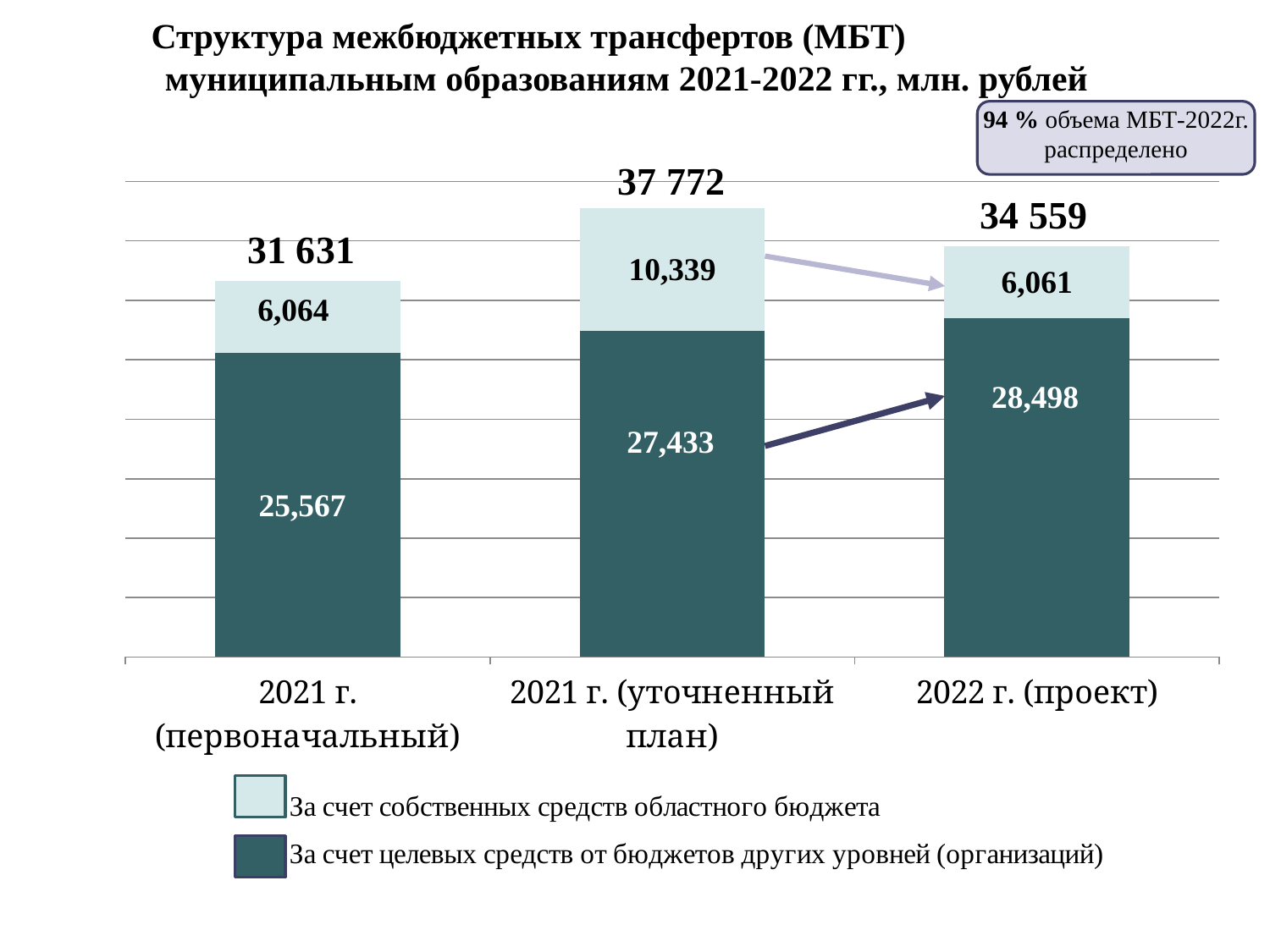
What is the value of 'За счет собственных средств областного бюджета' for '2021 г. (уточненный план)'? 10,339 How many categories are shown on the x axis? 3 What is the value of 'За счет собственных средств областного бюджета' for '2022 г. (проект)'? 6,061 What is the total of the stacked bar for '2022 г. (проект)'? 34 559 Which category has the highest total? 2021 г. (уточненный план) Which is larger: the 'За счет собственных средств областного бюджета' value for '2021 г. (первоначальный)' or for '2022 г. (проект)'? 2021 г. (первоначальный) What is the total of the stacked bar for '2021 г. (уточненный план)'? 37 772 How many series does the legend list? 2 What type of chart is shown on the slide? Stacked bar chart What is the value of 'За счет целевых средств от бюджетов других уровней (организаций)' for '2021 г. (первоначальный)'? 25,567 Which category has the lowest value for 'За счет целевых средств от бюджетов других уровней (организаций)'? 2021 г. (первоначальный) What is the difference between the 'За счет целевых средств от бюджетов других уровней (организаций)' values for '2022 г. (проект)' and '2021 г. (уточненный план)'? 1,065